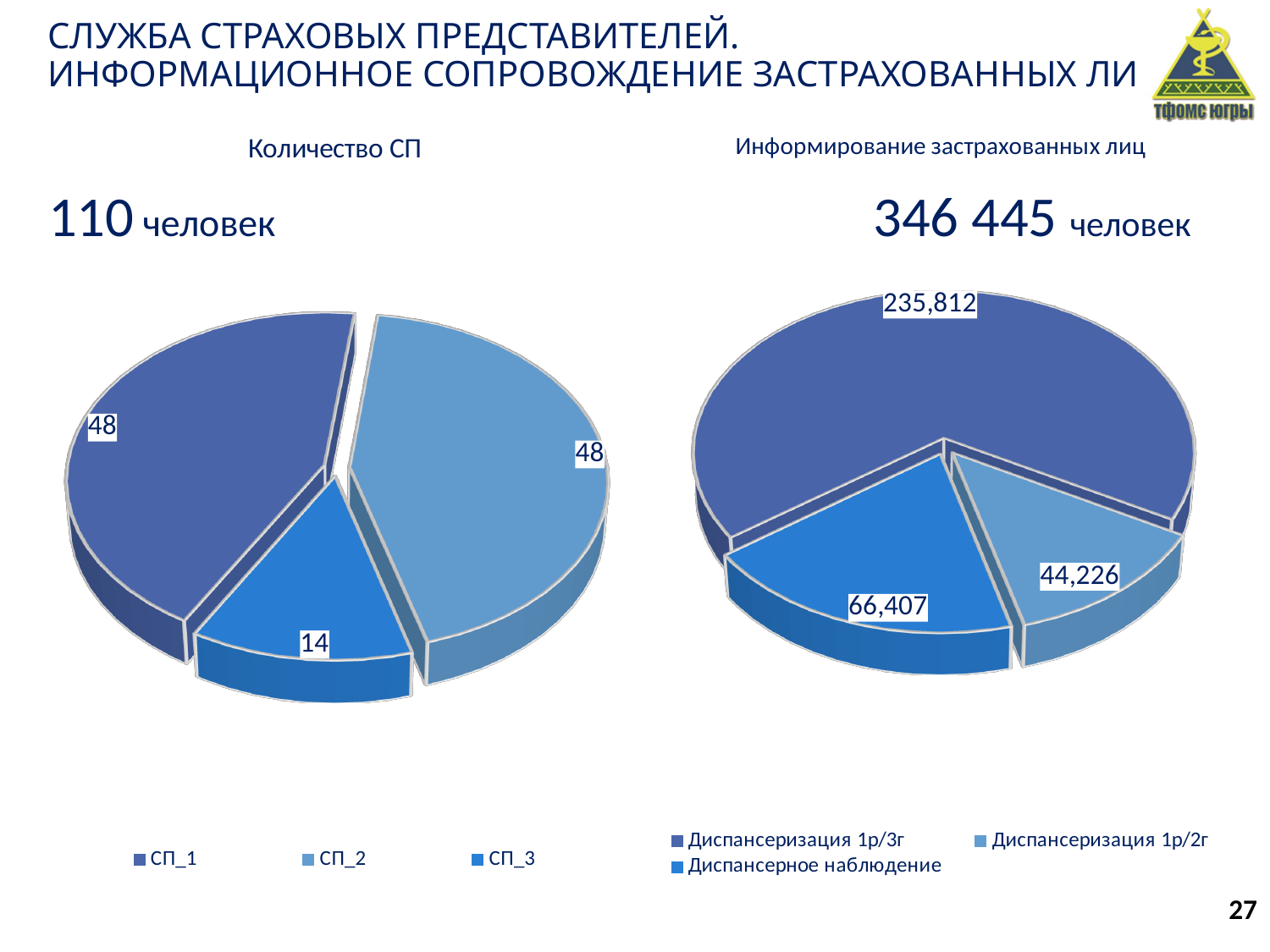
What kind of chart is 'Количество СП'? Pie chart In the 'Информирование застрахованных лиц' chart, what is the value for Диспансеризация 1р/3г? 235,812 In the 'Количество СП' chart, how many slices does the pie have? 3 How many entries does the legend of the 'Информирование застрахованных лиц' chart list? 3 In the 'Количество СП' chart, what is the value for СП_3? 14 In the 'Информирование застрахованных лиц' chart, which category has the largest value? Диспансеризация 1р/3г In the 'Информирование застрахованных лиц' chart, what is the value for Диспансерное наблюдение? 66,407 In the 'Информирование застрахованных лиц' chart, which category has the smallest value? Диспансеризация 1р/2г In the 'Количество СП' chart, what is the value for СП_1? 48 In the 'Количество СП' chart, what is the difference between the values for СП_2 and СП_3? 34 In the 'Количество СП' chart, which category has the smallest value? СП_3 In the 'Информирование застрахованных лиц' chart, which is larger: Диспансерное наблюдение or Диспансеризация 1р/2г? Диспансерное наблюдение